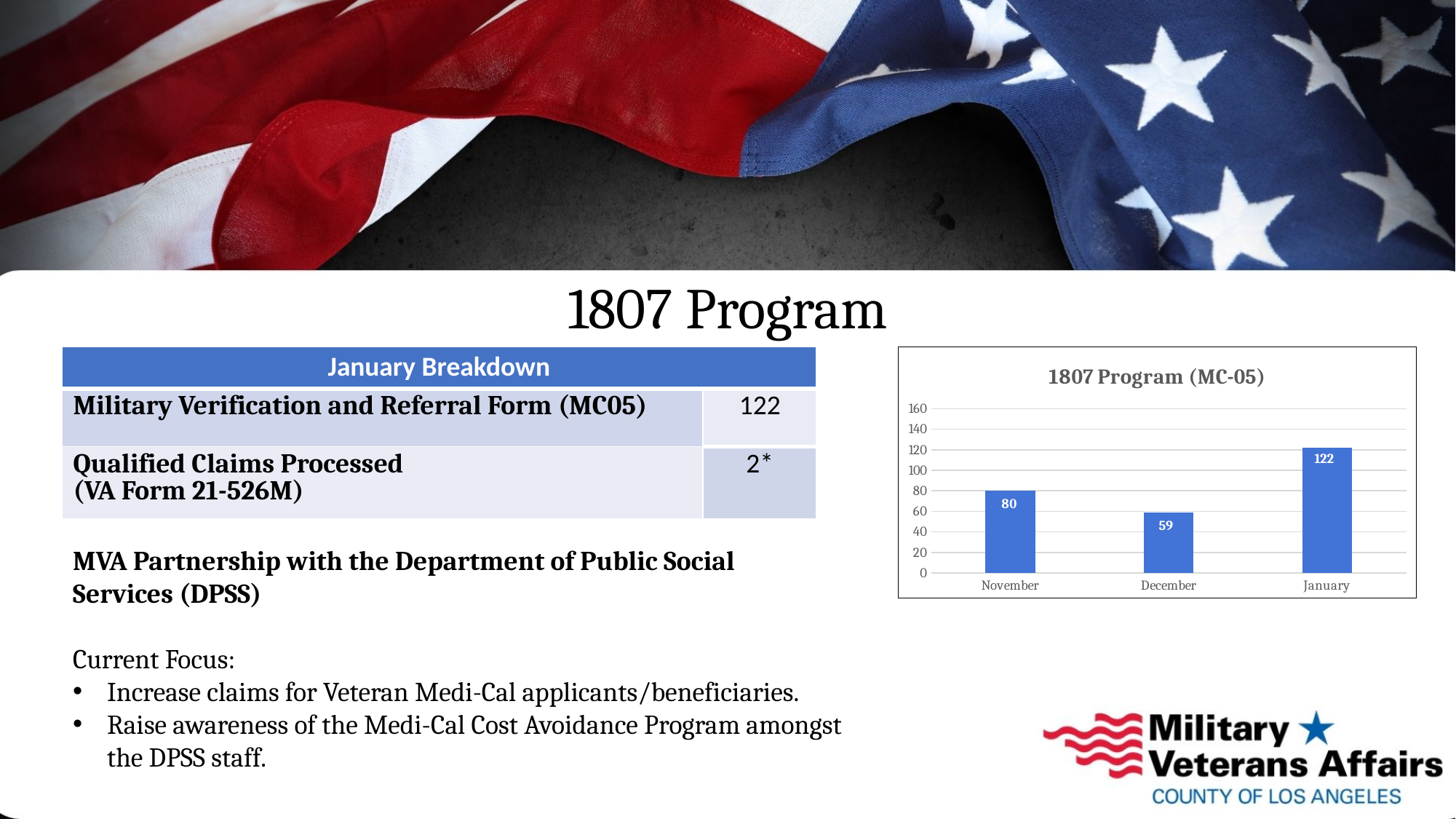
What is the value for December in the 1807 Program (MC-05) chart? 59 What is the value for January in the 1807 Program (MC-05) chart? 122 What kind of chart is the 1807 Program (MC-05) chart? Bar chart Is the value for January in the 1807 Program (MC-05) chart greater or less than 100? greater What is the value for November in the 1807 Program (MC-05) chart? 80 What is the difference between the November and December values in the 1807 Program (MC-05) chart? 21 Which is larger in the 1807 Program (MC-05) chart, the value for November or the value for December? November What is the difference between the January and December values in the 1807 Program (MC-05) chart? 63 What is the title of the chart on the slide? 1807 Program (MC-05) Which month has the lowest value in the 1807 Program (MC-05) chart? December Which month has the highest value in the 1807 Program (MC-05) chart? January How many months are shown on the x axis of the 1807 Program (MC-05) chart? 3